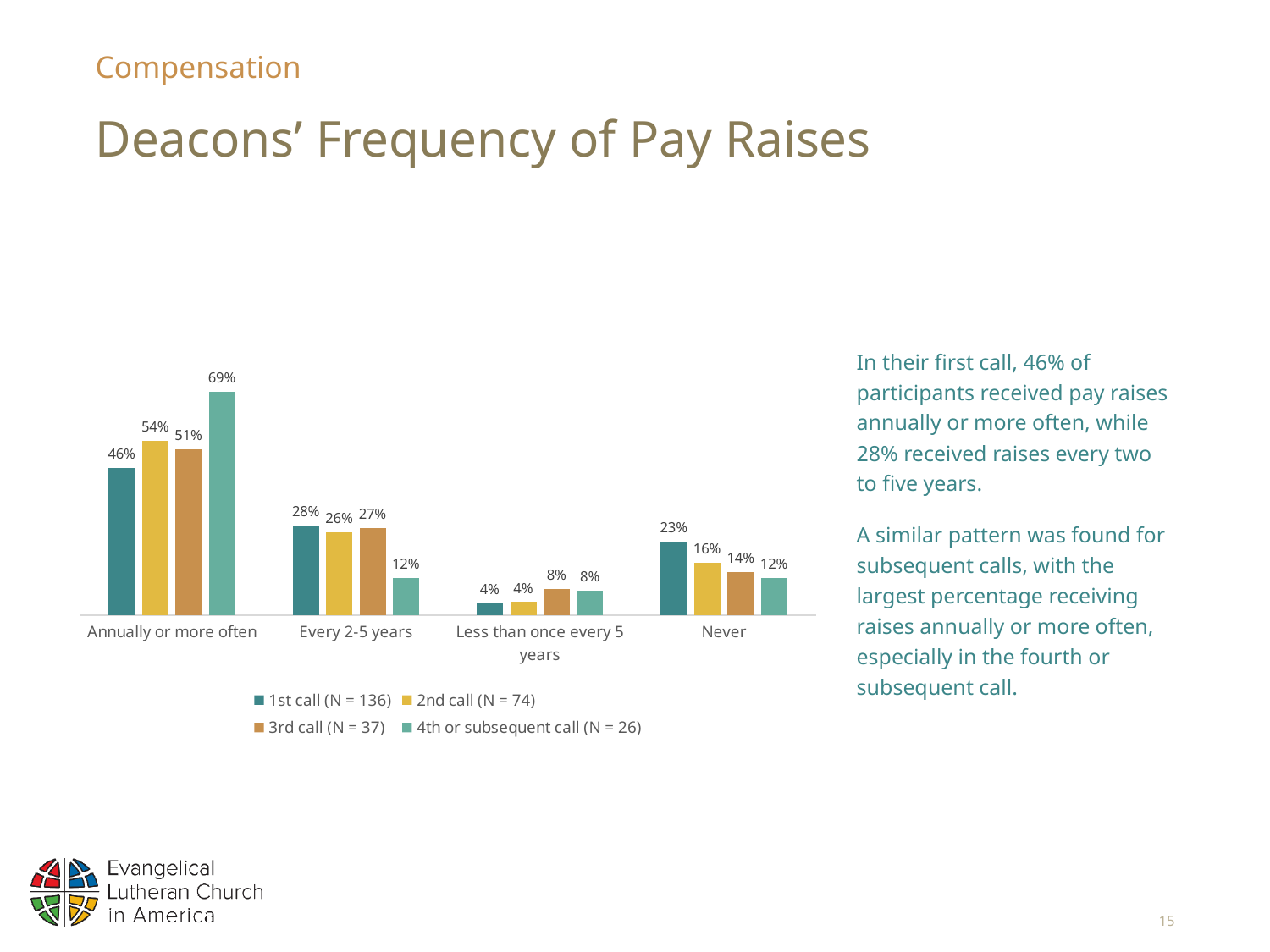
What kind of chart is shown on the slide? Bar chart What percentage of deacons in their 1st call received pay raises annually or more often? 46% How many categories are shown on the x axis? 4 Which series has the highest value in the 'Never' category? 1st call (N = 136) What is the value for the 4th or subsequent call series in the 'Annually or more often' category? 69% What percentage of 2nd call deacons reported never receiving a pay raise? 16% What is the value for the 3rd call series in the 'Every 2-5 years' category? 27% In the 'Every 2-5 years' category, which is larger: the 1st call value or the 4th or subsequent call value? 1st call What is the difference between the 4th or subsequent call value and the 1st call value in the 'Annually or more often' category? 23% What is the sample size (N) for the 3rd call series shown in the legend? 37 How many series does the legend list? 4 Which category has the lowest value for the 1st call series? Less than once every 5 years